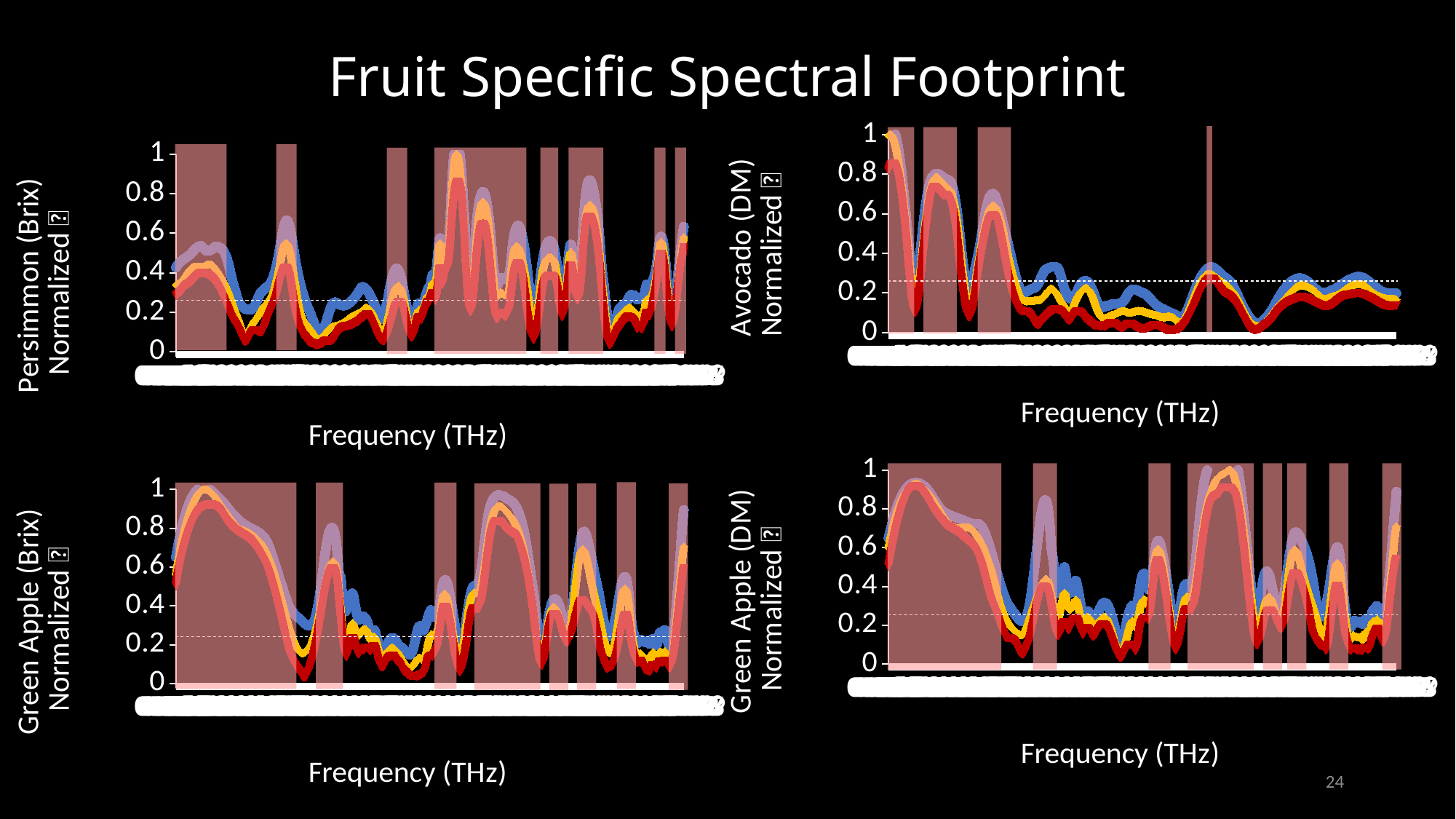
What is the title of the slide containing the four spectral charts? Fruit Specific Spectral Footprint In the Green Apple (DM) chart at the bottom right, is the dashed horizontal reference line greater or less than 0.4? less What is the highest tick value on the y-axis of the Avocado (DM) chart? 1 What kind of chart is the Persimmon (Brix) chart at the top left? line chart What is the y-axis label of the chart at the bottom left? Green Apple (Brix) Normalized What is the x-axis label of the Avocado (DM) chart at the top right? Frequency (THz) What is the lowest tick value on the y-axis of the Green Apple (DM) chart at the bottom right? 0 In the Persimmon (Brix) chart, is the tallest peak of the plotted lines greater or less than 0.8? greater In the Avocado (DM) chart, is the highest peak of the plotted lines greater or less than 0.8? greater How many charts are shown on the slide? 4